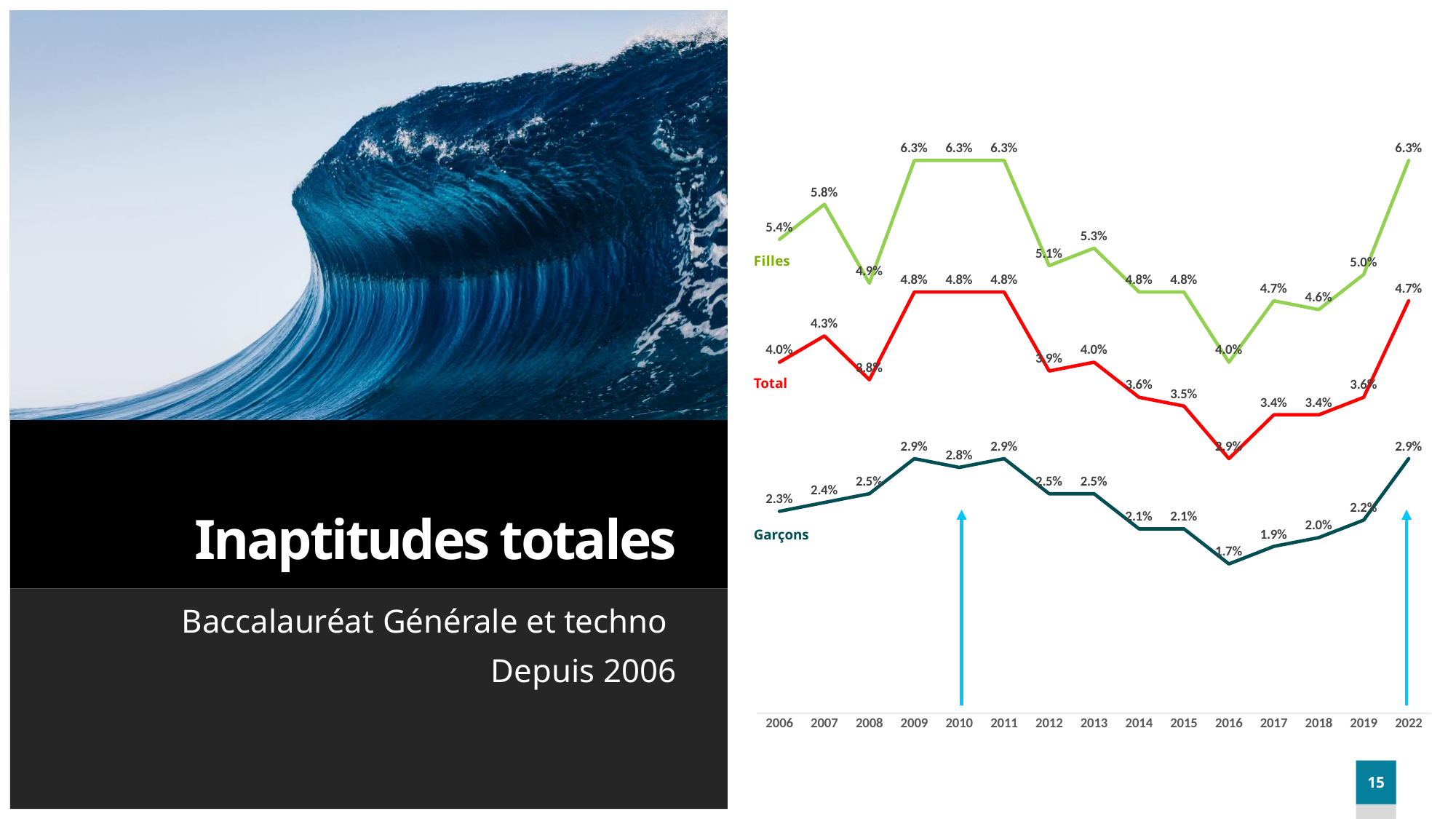
Which is larger, the Filles value in 2006 or the Filles value in 2016? 2006 What is the value for Garçons in 2010? 2.8% What is the value for Total in 2007? 4.3% How many series are plotted on the chart? 3 In which year is the Total series at its lowest? 2016 In which year is the Garçons series at its lowest? 2016 What kind of chart is shown on the slide? Line chart What is the difference between the Filles and Garçons values in 2022? 3.4% What is the value for Filles in 2022? 6.3% How many years are shown on the x axis? 15 What is the value for Garçons in 2016? 1.7% What is the difference between the Total values in 2016 and 2022? 1.8%